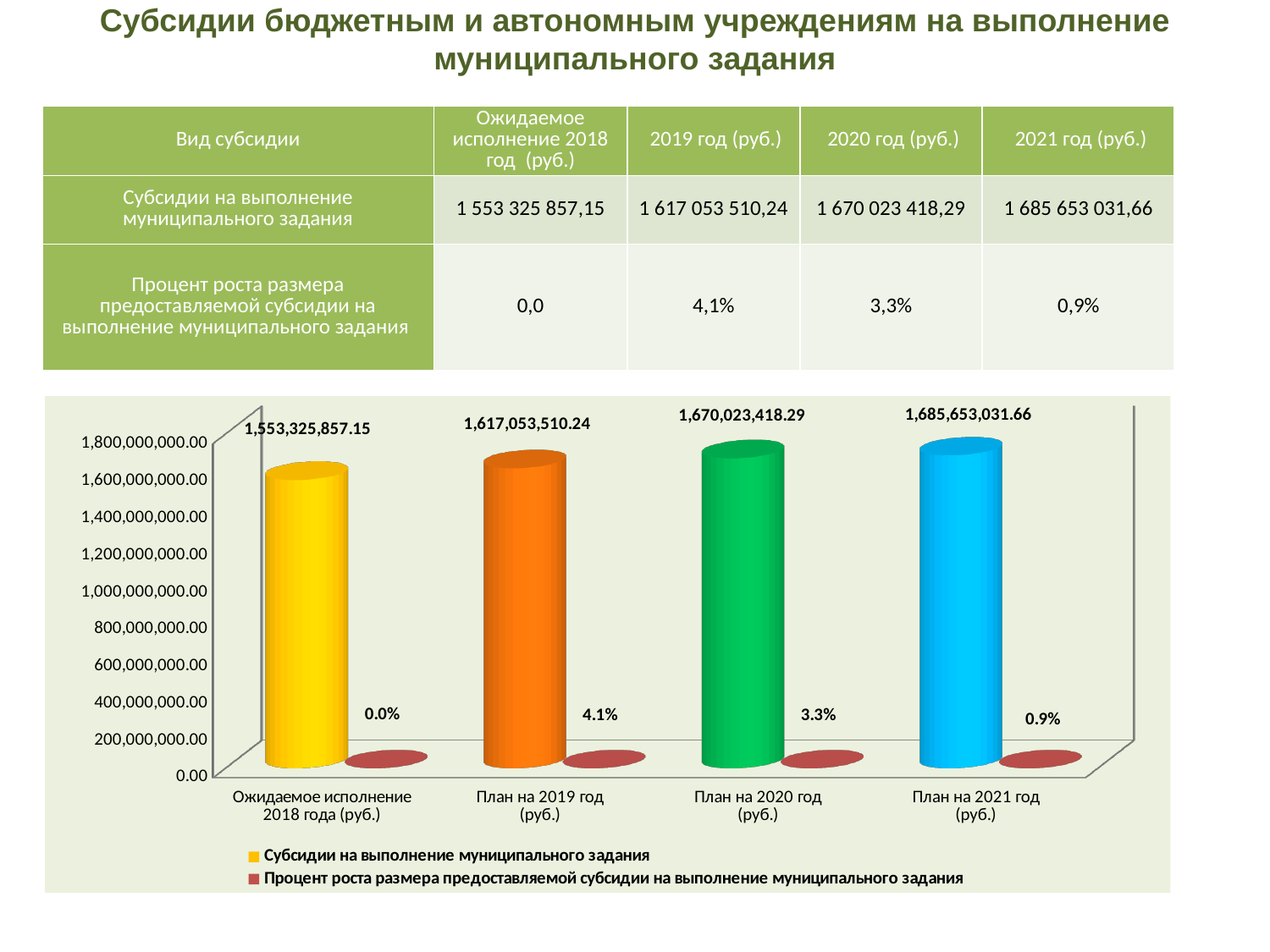
Which is larger: the growth percentage for 'План на 2019 год (руб.)' or for 'План на 2020 год (руб.)'? План на 2019 год (руб.) What is the value of the subsidy bar for 'Ожидаемое исполнение 2018 года (руб.)'? 1,553,325,857.15 How many categories are shown on the x axis of the chart? 4 Which category has the lowest subsidy value? Ожидаемое исполнение 2018 года (руб.) What growth percentage is shown for 'План на 2021 год (руб.)'? 0.9% Which category has the highest subsidy value? План на 2021 год (руб.) What growth percentage is shown for 'План на 2019 год (руб.)'? 4.1% How many series does the chart legend list? 2 What is the value of the subsidy bar for 'План на 2020 год (руб.)'? 1,670,023,418.29 What is the difference between the subsidy values for 'План на 2021 год (руб.)' and 'Ожидаемое исполнение 2018 года (руб.)'? 132,327,174.51 Is the subsidy value for 'План на 2019 год (руб.)' greater or less than 1,400,000,000.00? greater Do the subsidy values rise or fall from left to right along the x axis? rise